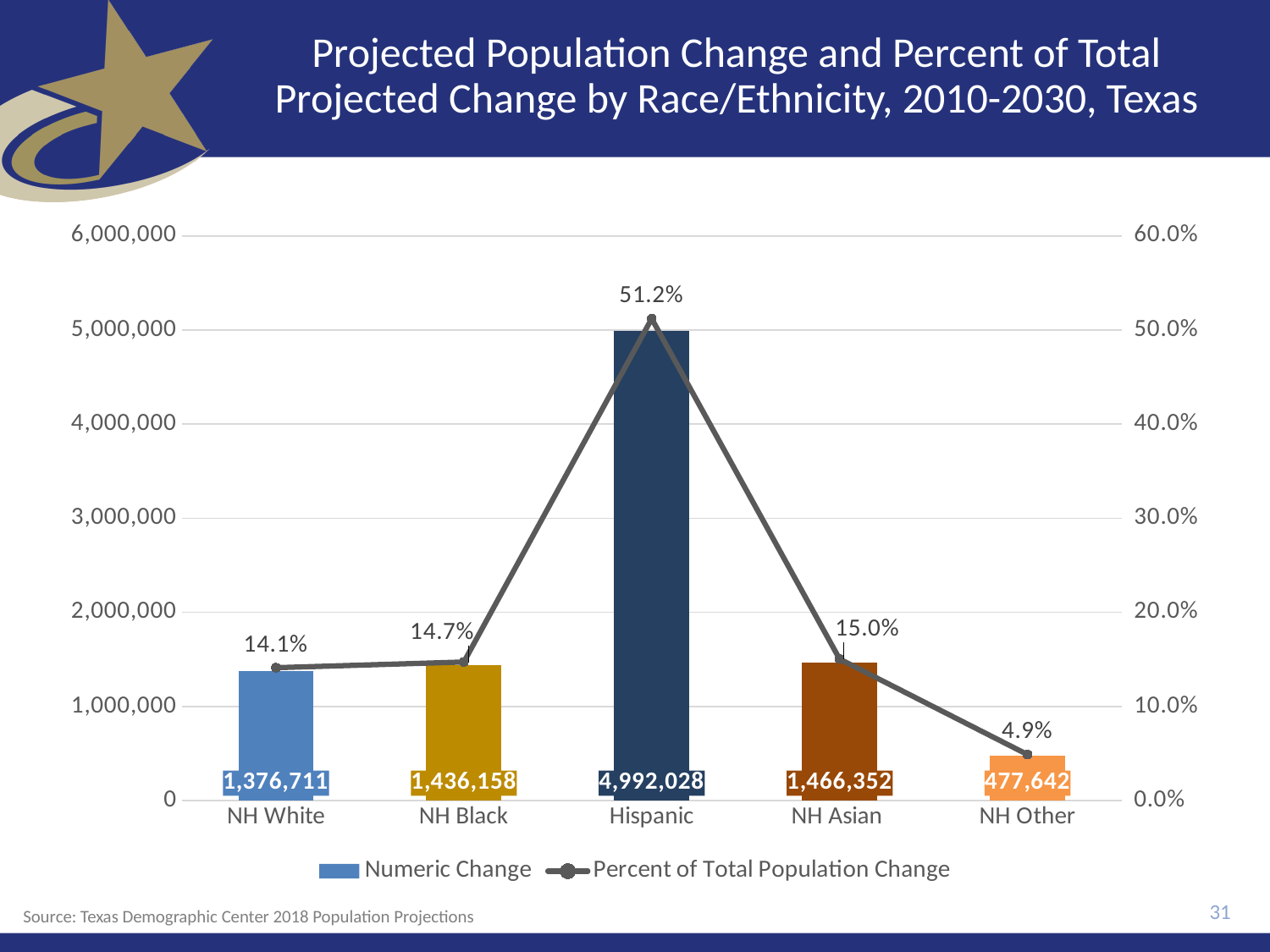
What is the Numeric Change value for Hispanic? 4,992,028 Which has a larger Numeric Change, NH Asian or NH Black? NH Asian Is the Numeric Change for NH White greater or less than 1,000,000? greater How many race/ethnicity categories are shown on the x axis? 5 What is the Numeric Change value for NH Other? 477,642 What is the Percent of Total Population Change for NH Asian? 15.0% What is the difference in Numeric Change between NH Black and NH White? 59,447 Which race/ethnicity category has the highest Numeric Change? Hispanic What kind of chart is used to show the Numeric Change series? Bar chart Which race/ethnicity category has the lowest Percent of Total Population Change? NH Other How many series does the legend list? 2 What is the difference in Percent of Total Population Change between Hispanic and NH Asian? 36.2%